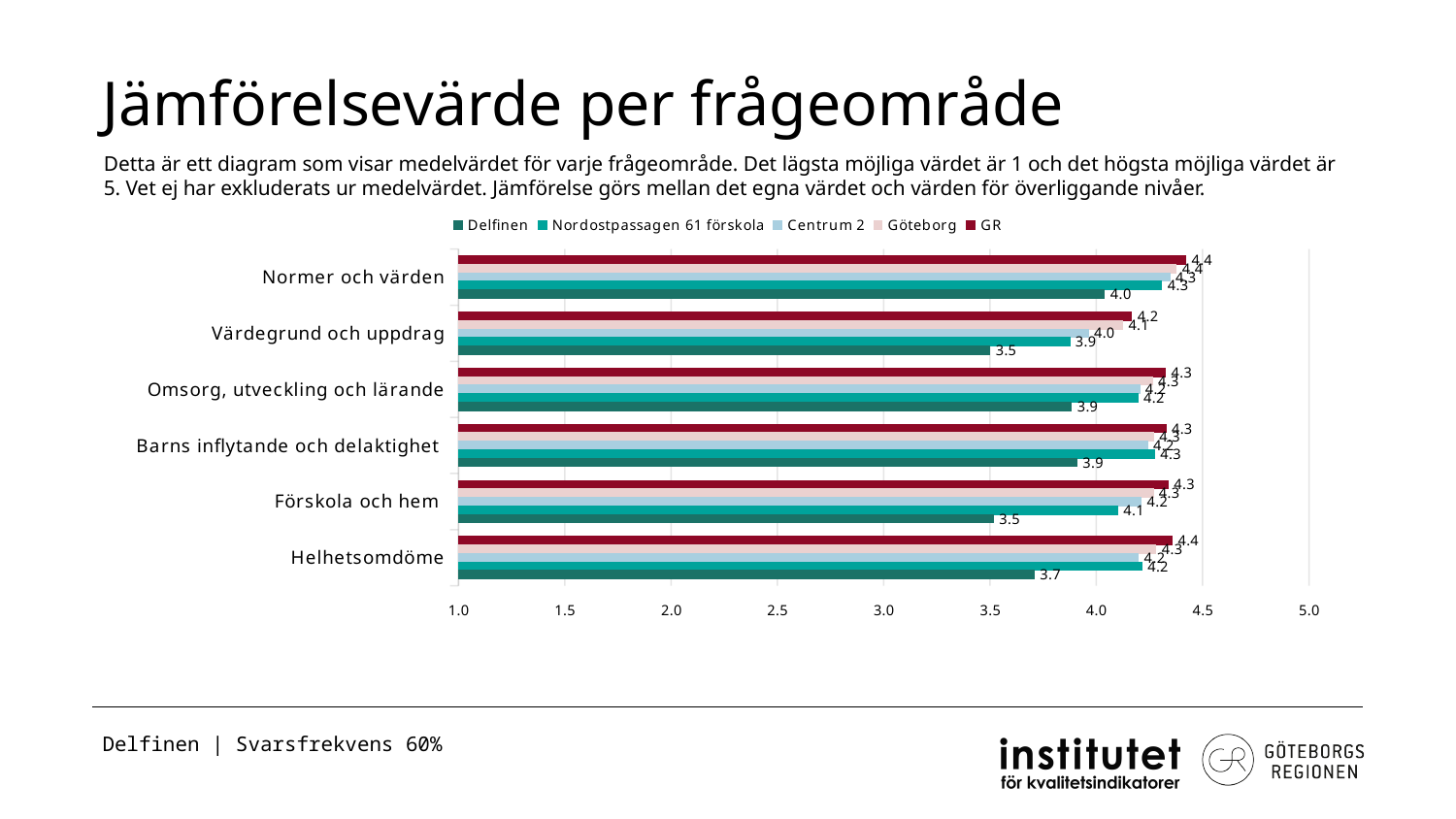
Which is larger in 'Helhetsomdöme': the Delfinen value or the Nordostpassagen 61 förskola value? Nordostpassagen 61 förskola How many series does the legend list? 5 What is the value for Nordostpassagen 61 förskola in 'Värdegrund och uppdrag'? 3.9 What is the difference between the Nordostpassagen 61 förskola value and the Delfinen value in 'Förskola och hem'? 0.6 Which category has the highest value for Delfinen? Normer och värden How many question areas (categories) are shown on the y axis? 6 Is the value for Delfinen in 'Omsorg, utveckling och lärande' greater or less than 4.0? less What is the value for Delfinen in 'Värdegrund och uppdrag'? 3.5 What is the value for Nordostpassagen 61 förskola in 'Förskola och hem'? 4.1 What kind of chart is shown on the slide? bar chart What is the value for Delfinen in 'Helhetsomdöme'? 3.7 What is the value for Delfinen in 'Normer och värden'? 4.0